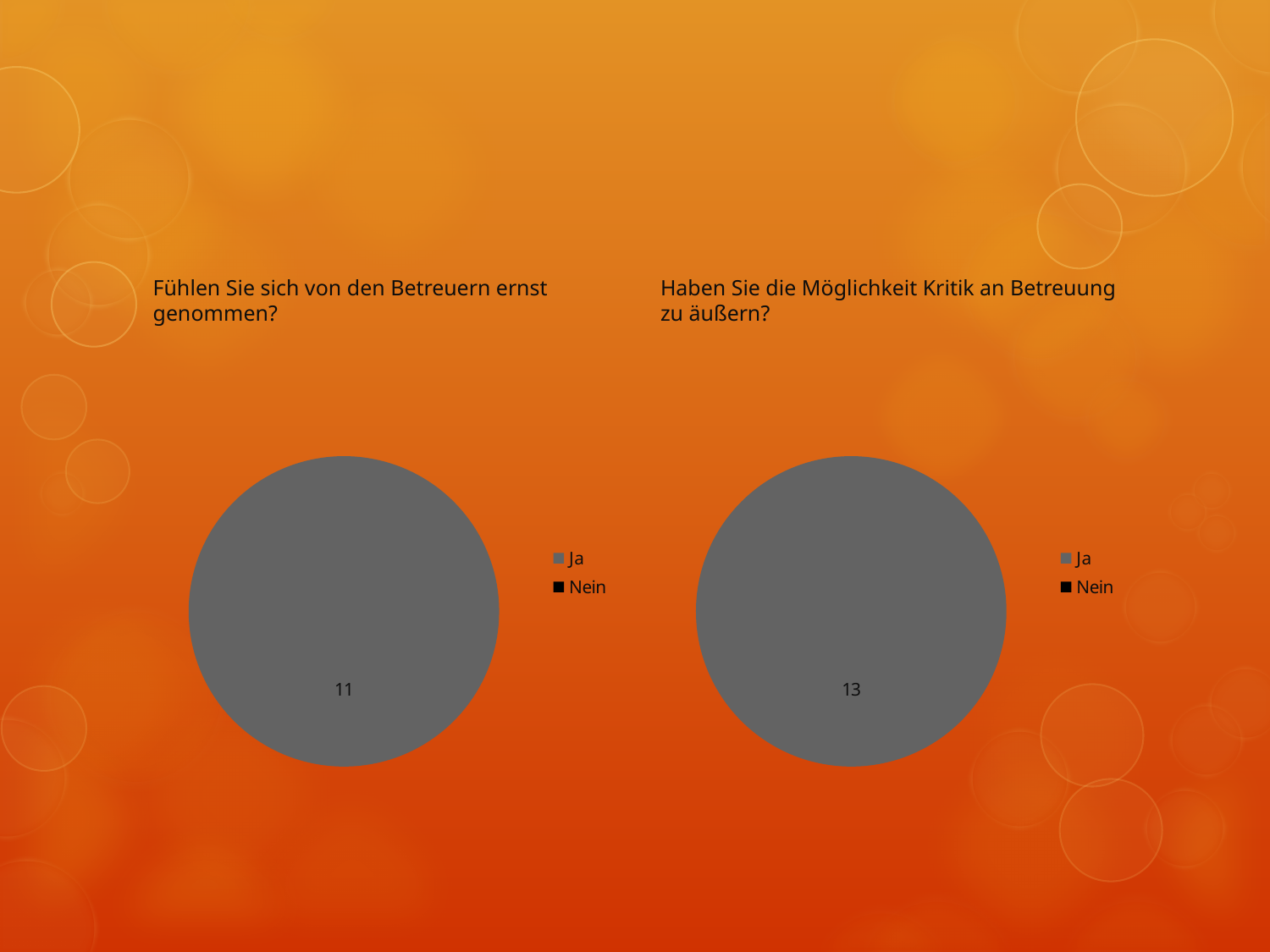
What kind of chart is used on this slide? Pie chart How many entries does the legend of the left pie chart list? 2 How many pie charts are shown on the slide? 2 Which category is the largest in the right pie chart ("Haben Sie die Möglichkeit Kritik an Betreuung zu äußern?")? Ja What are the legend entries of the right pie chart? Ja, Nein Which chart shows the larger value for Ja, the left one or the right one? The right one Which category is the largest in the left pie chart ("Fühlen Sie sich von den Betreuern ernst genommen?")? Ja What is the title of the left pie chart? Fühlen Sie sich von den Betreuern ernst genommen? What is the difference between the Ja value in the right pie chart and the Ja value in the left pie chart? 2 In the right pie chart ("Haben Sie die Möglichkeit Kritik an Betreuung zu äußern?"), what value is shown for Ja? 13 In the left pie chart ("Fühlen Sie sich von den Betreuern ernst genommen?"), what value is shown for Ja? 11